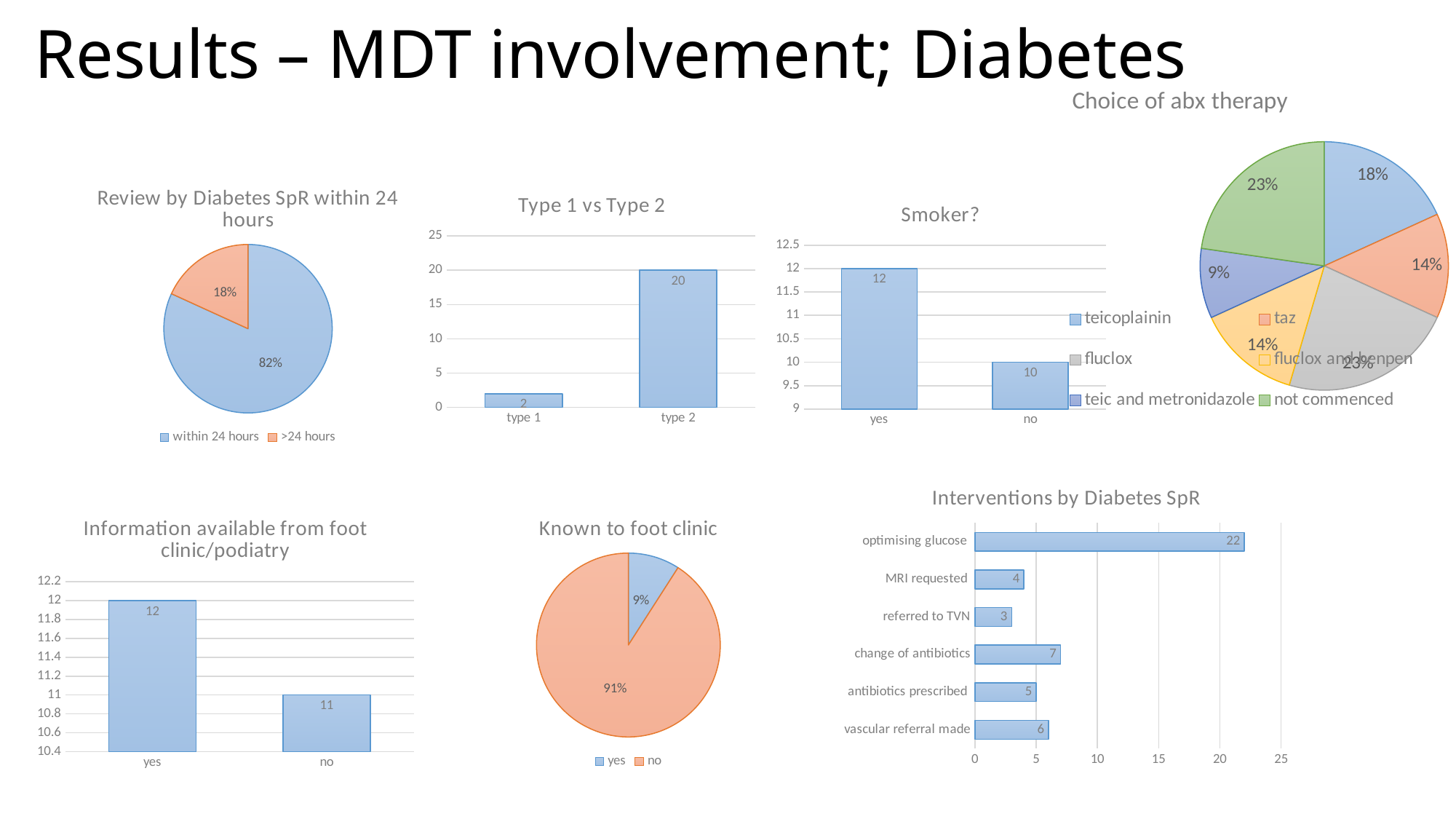
In the 'Interventions by Diabetes SpR' chart, what is the value for 'change of antibiotics'? 7 In the 'Smoker?' chart, which category is larger, 'yes' or 'no'? yes In the 'Information available from foot clinic/podiatry' chart, what is the value for 'no'? 11 In the 'Interventions by Diabetes SpR' chart, which category has the lowest value? referred to TVN In the 'Interventions by Diabetes SpR' chart, how many categories are plotted? 6 In the 'Smoker?' chart, what is the value for 'yes'? 12 In the 'Interventions by Diabetes SpR' chart, which category has the highest value? optimising glucose In the 'Known to foot clinic' pie chart, what share is labelled 'yes'? 9% In the 'Review by Diabetes SpR within 24 hours' pie chart, what share is labelled 'within 24 hours'? 82% In the 'Type 1 vs Type 2' chart, what is the difference between the type 2 and type 1 values? 18 In the 'Choice of abx therapy' pie chart, what share is shown for the 'teic and metronidazole' slice? 9% In the 'Type 1 vs Type 2' chart, what is the value for type 2? 20